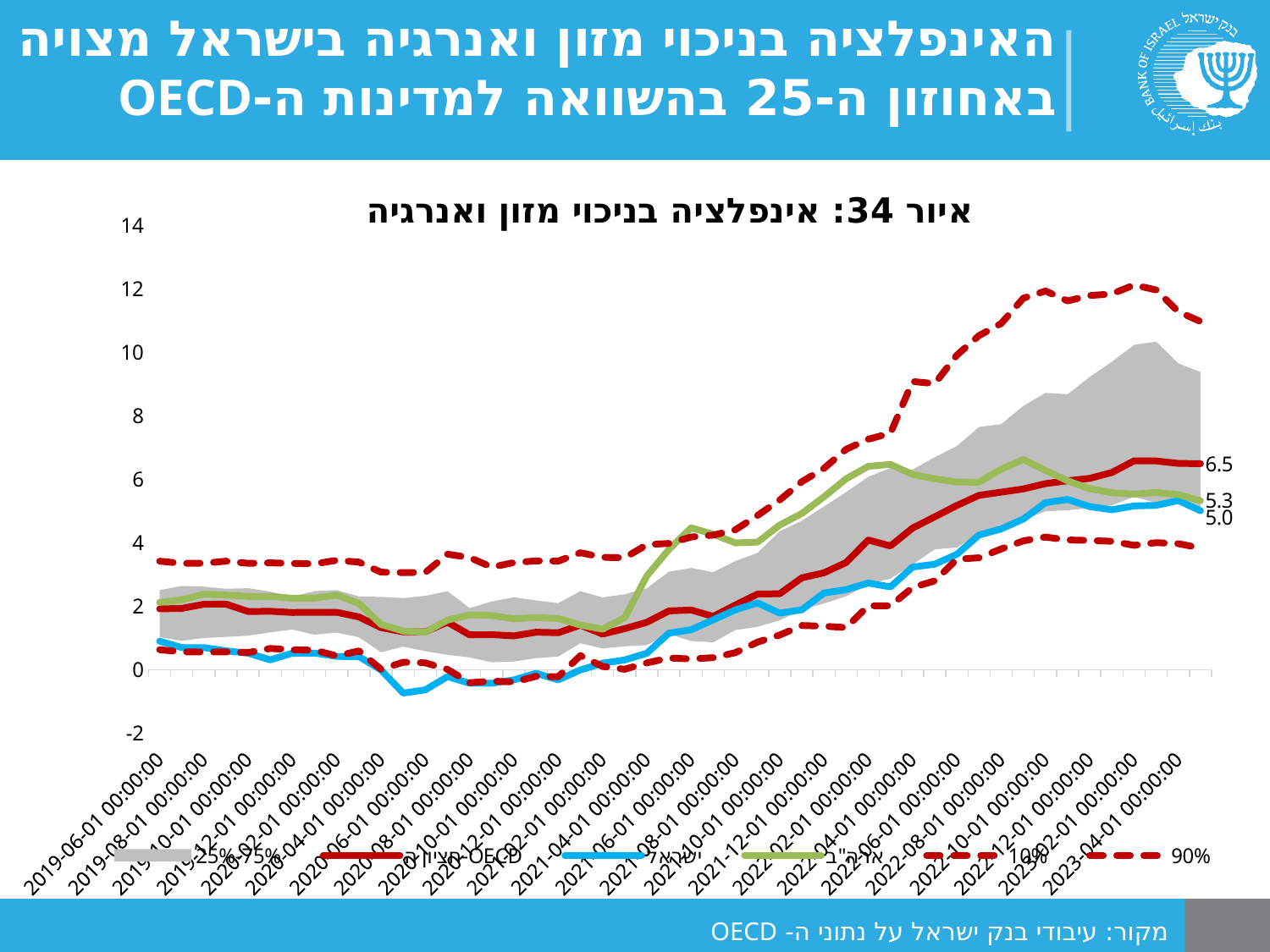
What is the title of the chart? איור 34: אינפלציה בניכוי מזון ואנרגיה What is the difference between the final labelled values of the חציון OECD line (6.5) and the ישראל line (5.0)? 1.5 What is the value printed at the end of the ארה"ב (US) line? 5.3 Does the ישראל (Israel) line rise or fall overall from 2019 to 2023? rise Is the value of the 90% line at 2023-04-01 greater or less than 10? greater How many series does the legend list? 6 Among the three lines with printed end values, which has the highest final value? חציון OECD (6.5) What kind of chart is shown on the slide? line chart What is the value printed at the end of the חציון OECD (OECD median) line? 6.5 What is the value printed at the end of the ישראל (Israel) line? 5.0 Is the value of the 10% line at 2023-04-01 greater or less than 6? less At the end of the series, which is larger: the חציון OECD value or the ישראל value? חציון OECD